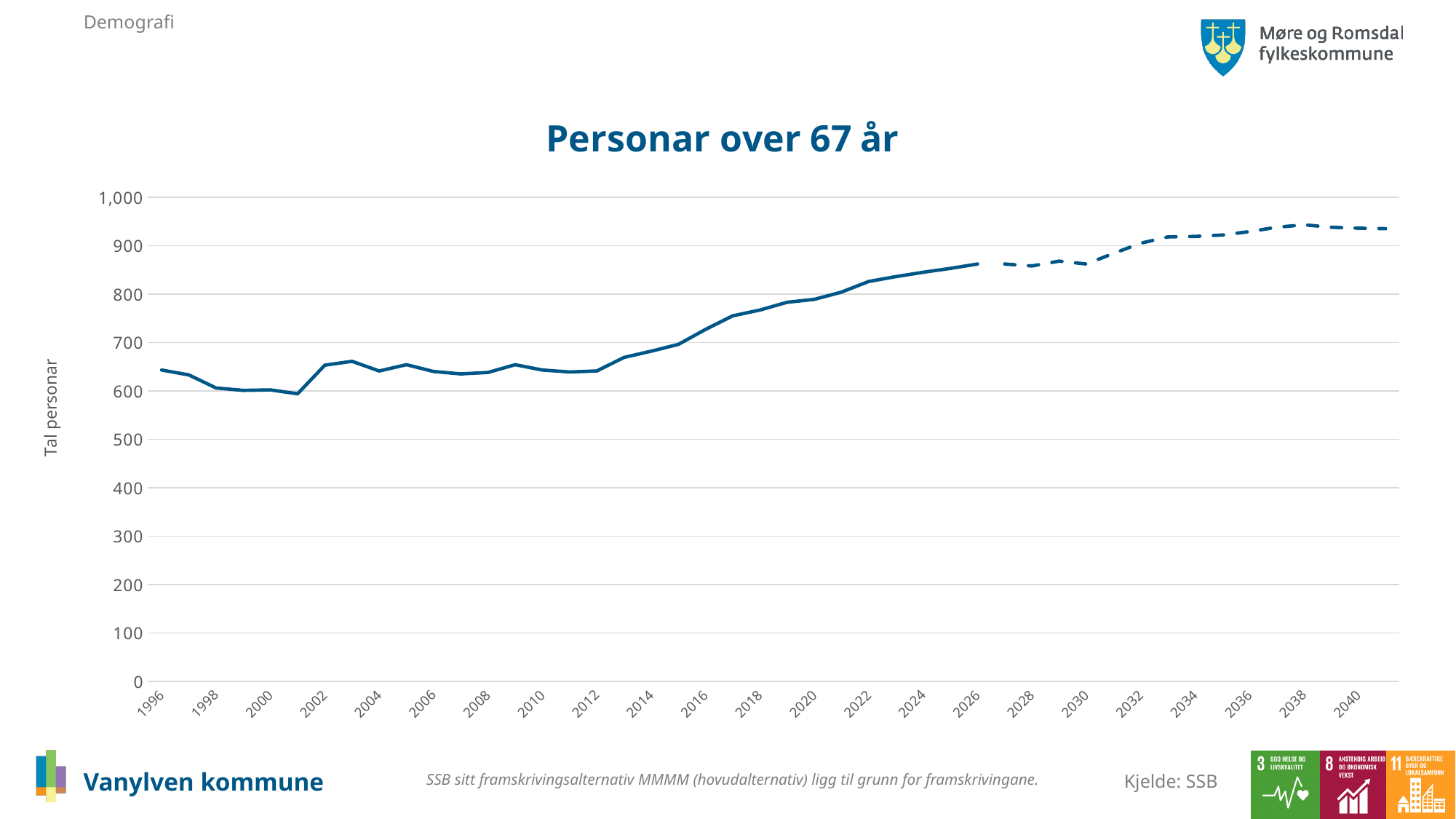
Is the value for 2026 greater or less than 800? greater Is the value for 2040 greater or less than 1,000? less Is the value for 2020 greater or less than 700? greater Which year has the larger value, 1996 or 2026? 2026 Do the values generally rise or fall between 2012 and 2026? rise What kind of chart is shown on the slide? line chart What is the label on the vertical axis of the chart? Tal personar Which year has the larger value, 2001 or 2002? 2002 What is the title of the chart? Personar over 67 år